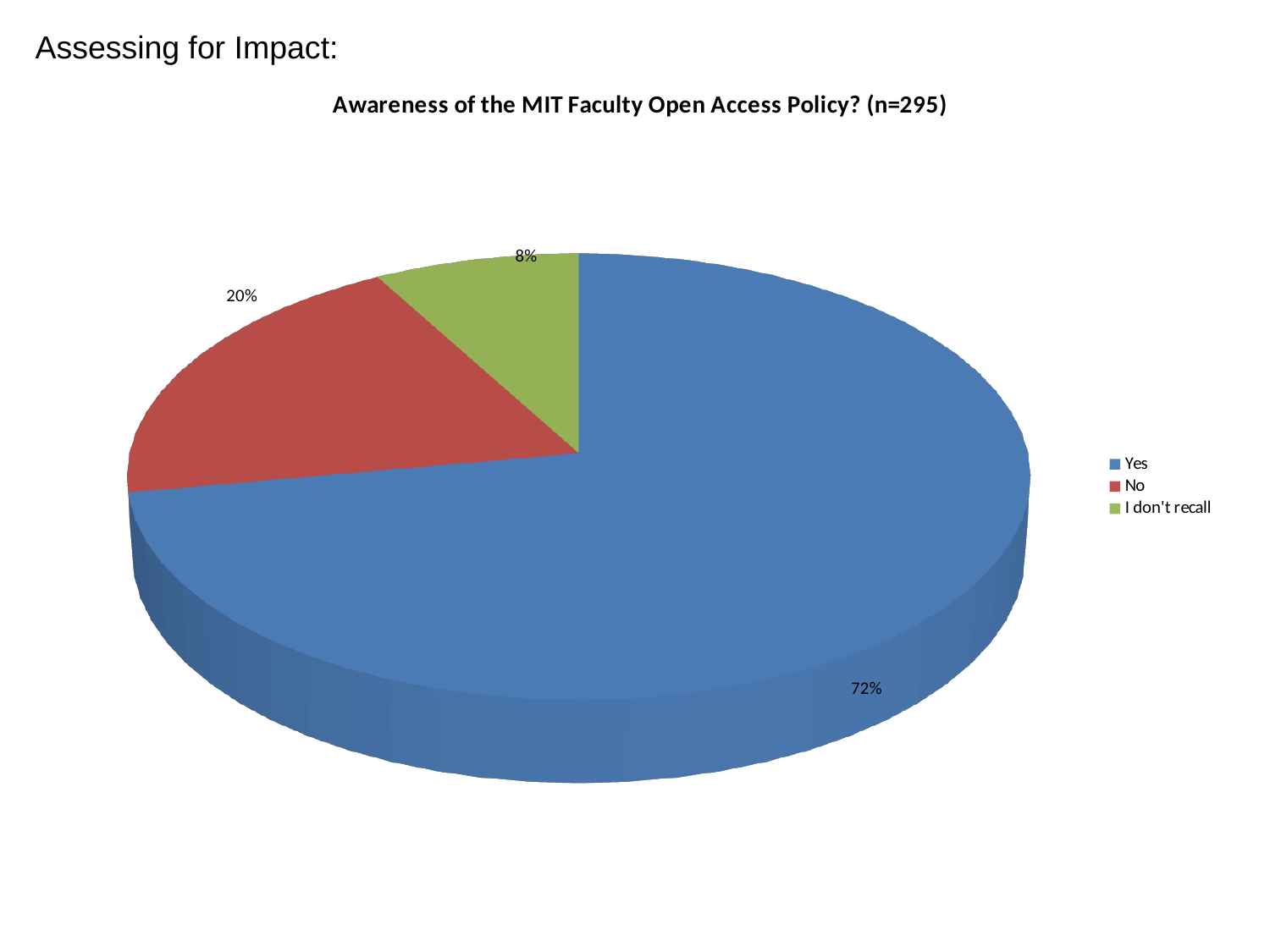
What percentage of respondents answered "Yes"? 72% What percentage of respondents answered "I don't recall"? 8% What is the difference in percentage points between the "Yes" and "No" slices? 52 What is the title of the chart? Awareness of the MIT Faculty Open Access Policy? (n=295) Which slice is larger, "No" or "I don't recall"? No How many entries does the legend list? 3 How many slices does the pie chart have? 3 What colour is the "Yes" slice? blue Which response has the largest share of the pie? Yes What percentage of respondents answered "No"? 20% What type of chart is shown on the slide? pie chart Which response has the smallest share of the pie? I don't recall